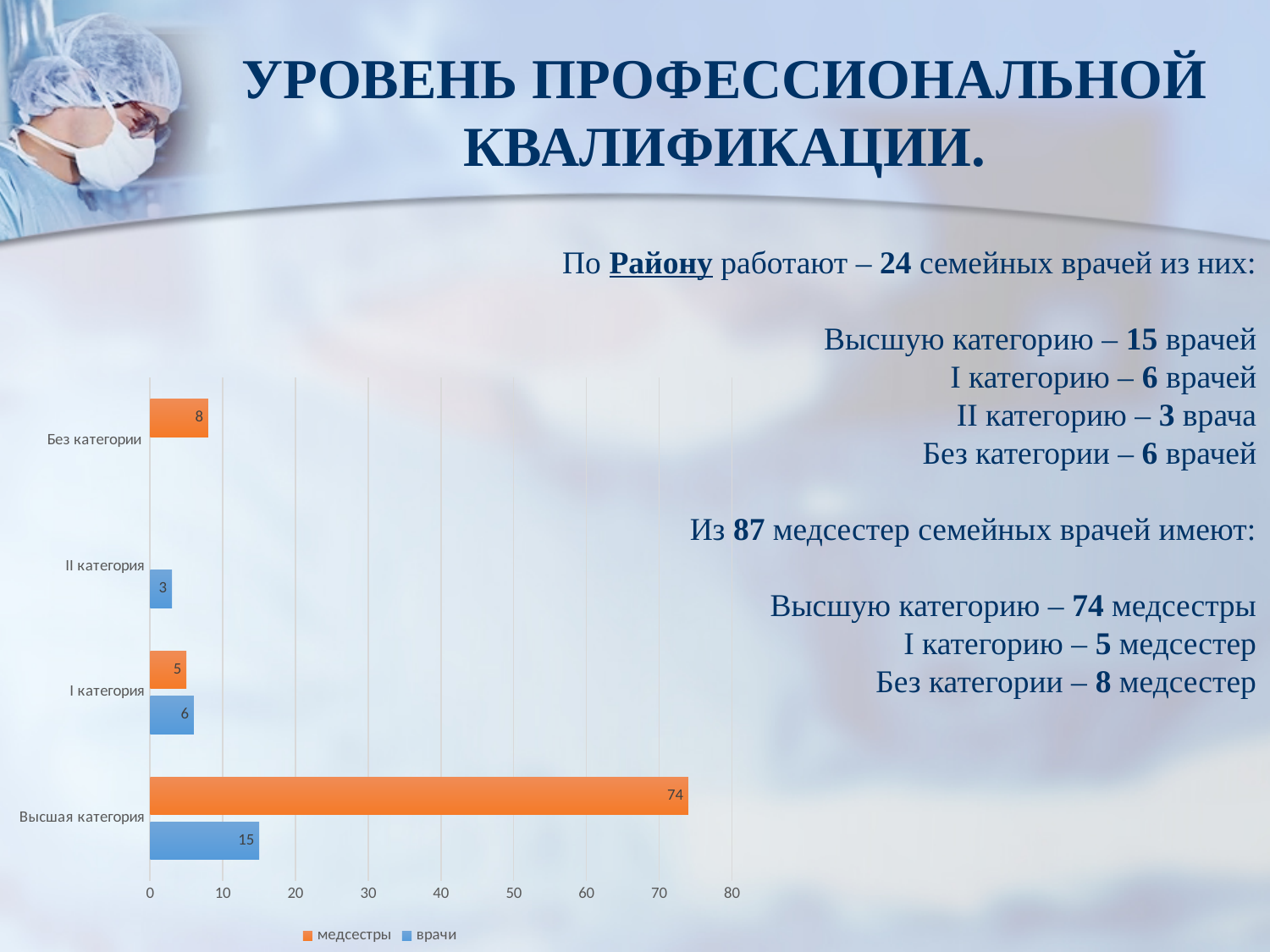
What is the value for врачи in the I категория category? 6 What kind of chart is shown on the slide? bar chart What is the value for врачи in the II категория category? 3 What is the difference between медсестры and врачи in the Высшая категория category? 59 Which category has the highest value for медсестры? Высшая категория How many series does the legend list? 2 What is the value for медсестры in the I категория category? 5 Which category has the lowest value for врачи among those with a plotted bar? II категория What is the value for врачи in the Высшая категория category? 15 What is the value for медсестры in the Высшая категория category? 74 What is the value for медсестры in the Без категории category? 8 In the I категория category, which is larger: медсестры or врачи? врачи